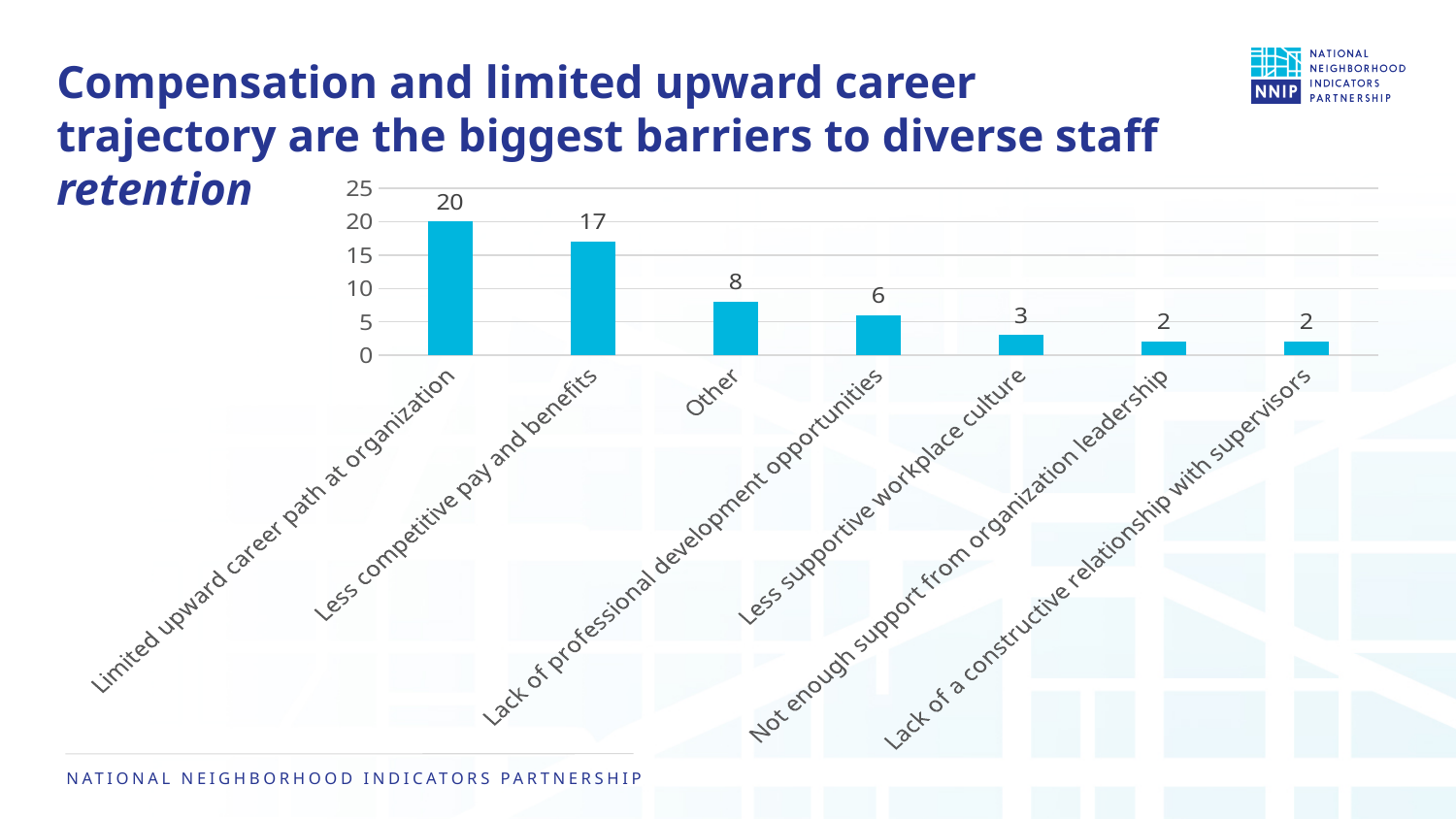
What is the value for "Less competitive pay and benefits"? 17 What is the difference between the values for "Limited upward career path at organization" and "Less competitive pay and benefits"? 3 What is the value for "Less supportive workplace culture"? 3 What is the value for "Lack of professional development opportunities"? 6 How many categories are shown on the chart? 7 What is the value for "Limited upward career path at organization"? 20 What kind of chart is shown on the slide? Bar chart Is the value for "Less competitive pay and benefits" greater or less than 15? greater Which category has the highest value? Limited upward career path at organization What is the value for "Not enough support from organization leadership"? 2 Do the values rise or fall from left to right across the categories? Fall Which is larger, the value for "Other" or the value for "Lack of professional development opportunities"? Other